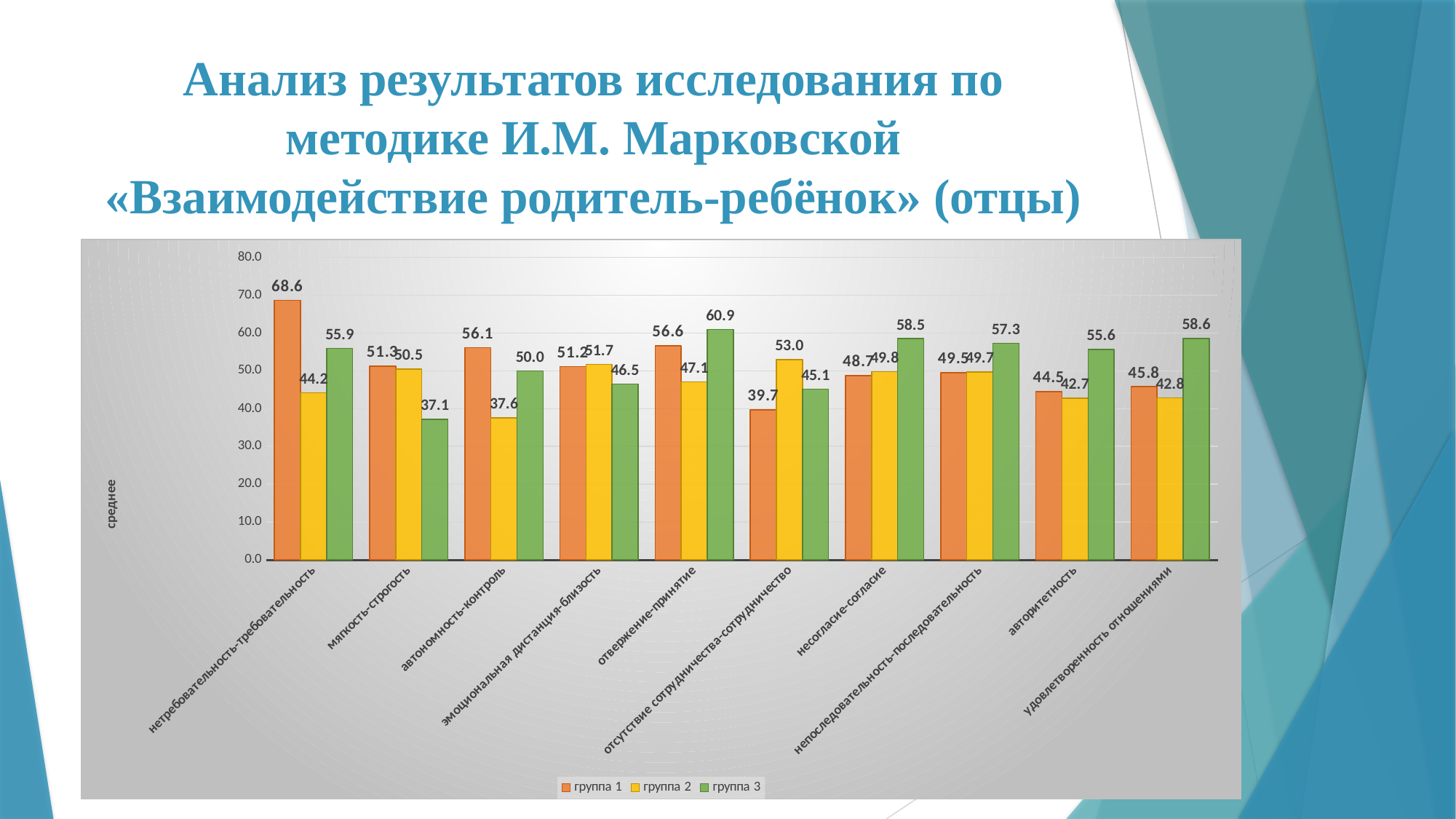
How many series does the legend list? 3 What is the value for группа 1 in the category нетребовательность-требовательность? 68.6 How many categories are shown on the x axis? 10 In the category отсутствие сотрудничества-сотрудничество, which series has the larger value, группа 1 or группа 2? группа 2 What is the value for группа 3 in the category отвержение-принятие? 60.9 In which category does группа 1 have its highest value? нетребовательность-требовательность In which category does группа 3 have its lowest value? мягкость-строгость What is the difference between группа 3 and группа 1 in the category авторитетность? 11.1 What is the difference between группа 1 and группа 2 in the category нетребовательность-требовательность? 24.4 What kind of chart is shown on the slide? bar chart What is the value for группа 3 in the category удовлетворенность отношениями? 58.6 What is the value for группа 2 in the category автономность-контроль? 37.6